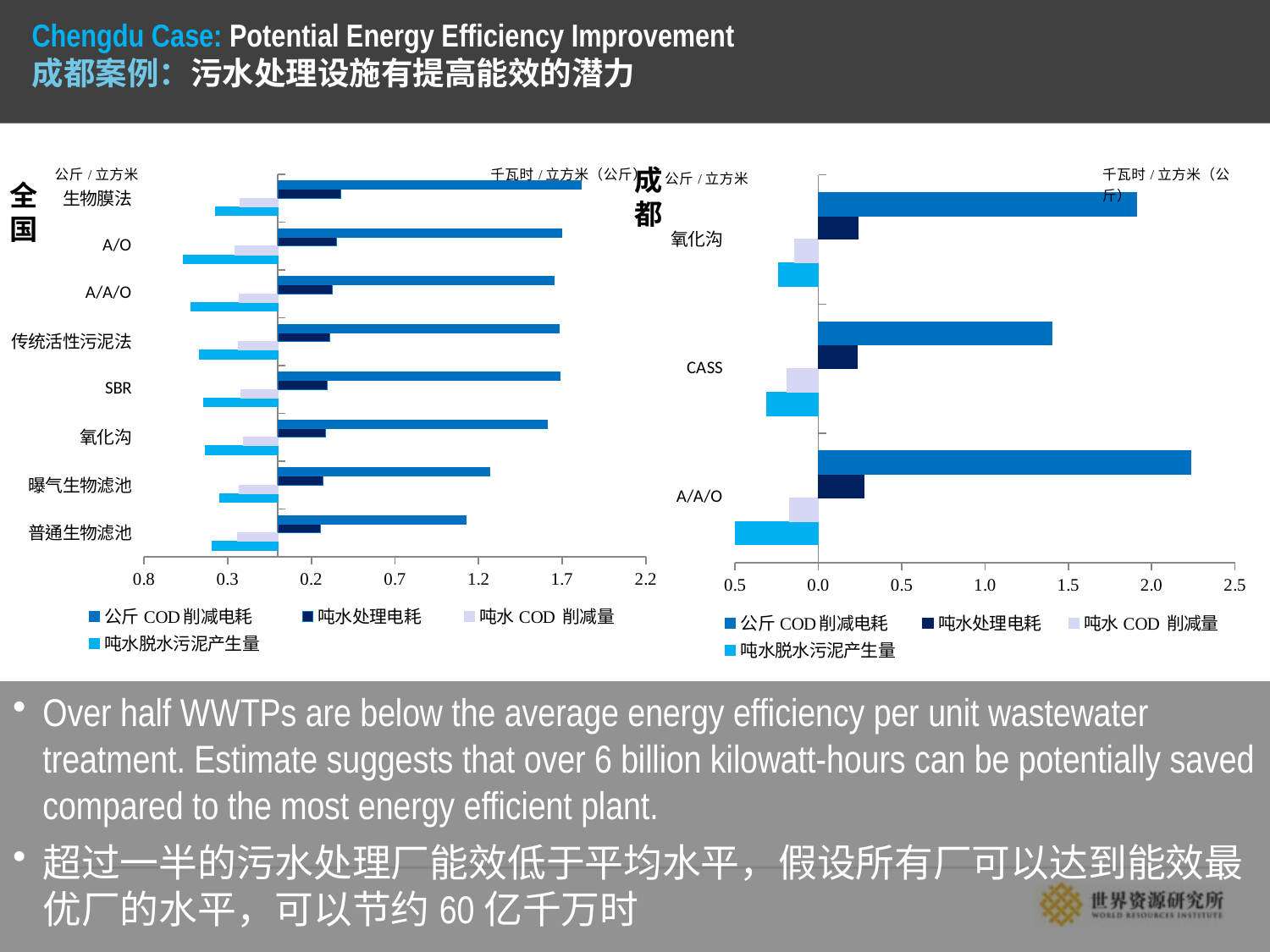
How many categories are shown on the left chart (全国)? 8 On the left chart (全国), is the value of 公斤 COD 削减电耗 for 生物膜法 greater or less than 1.7? greater On the right chart (成都), is the value of 公斤 COD 削减电耗 for A/A/O greater or less than 2.0? greater On the right chart (成都), which category has the highest value for 公斤 COD 削减电耗? A/A/O How many series does the legend of the right chart (成都) list? 4 On the right chart (成都), which category has the lowest value for 公斤 COD 削减电耗? CASS On the left chart (全国), which category has the lowest value for 公斤 COD 削减电耗? 普通生物滤池 On the right chart (成都), is the value of 公斤 COD 削减电耗 for CASS greater or less than 1.5? less What kind of chart is the left chart (全国)? bar chart On the left chart (全国), which is larger for 公斤 COD 削减电耗: 生物膜法 or 普通生物滤池? 生物膜法 How many categories are shown on the right chart (成都)? 3 On the left chart (全国), which category has the highest value for 公斤 COD 削减电耗? 生物膜法